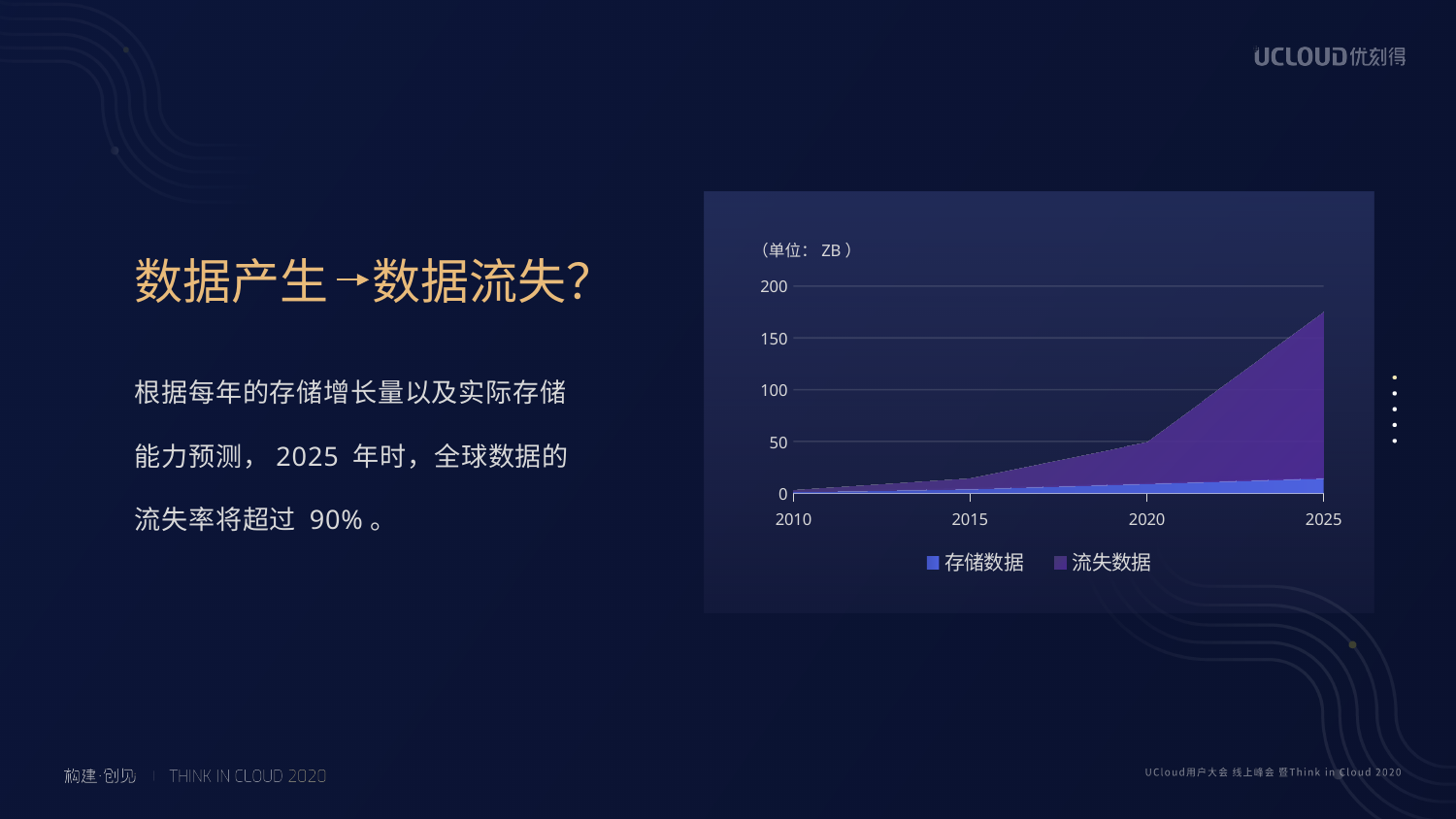
What unit is stated for the chart's values? ZB What are the two series named in the chart legend? 存储数据 and 流失数据 Do the values in the chart rise or fall from 2010 to 2025? rise What kind of chart is shown on the slide? area chart Is the total stacked value in 2015 greater or less than 50? less Is the total stacked value in 2025 greater or less than 150? greater What is the highest value shown on the y axis? 200 In 2025, which series is larger, 存储数据 or 流失数据? 流失数据 How many year labels are shown on the x axis? 4 How many series does the chart legend list? 2 Is the value for 存储数据 in 2025 greater or less than 50? less